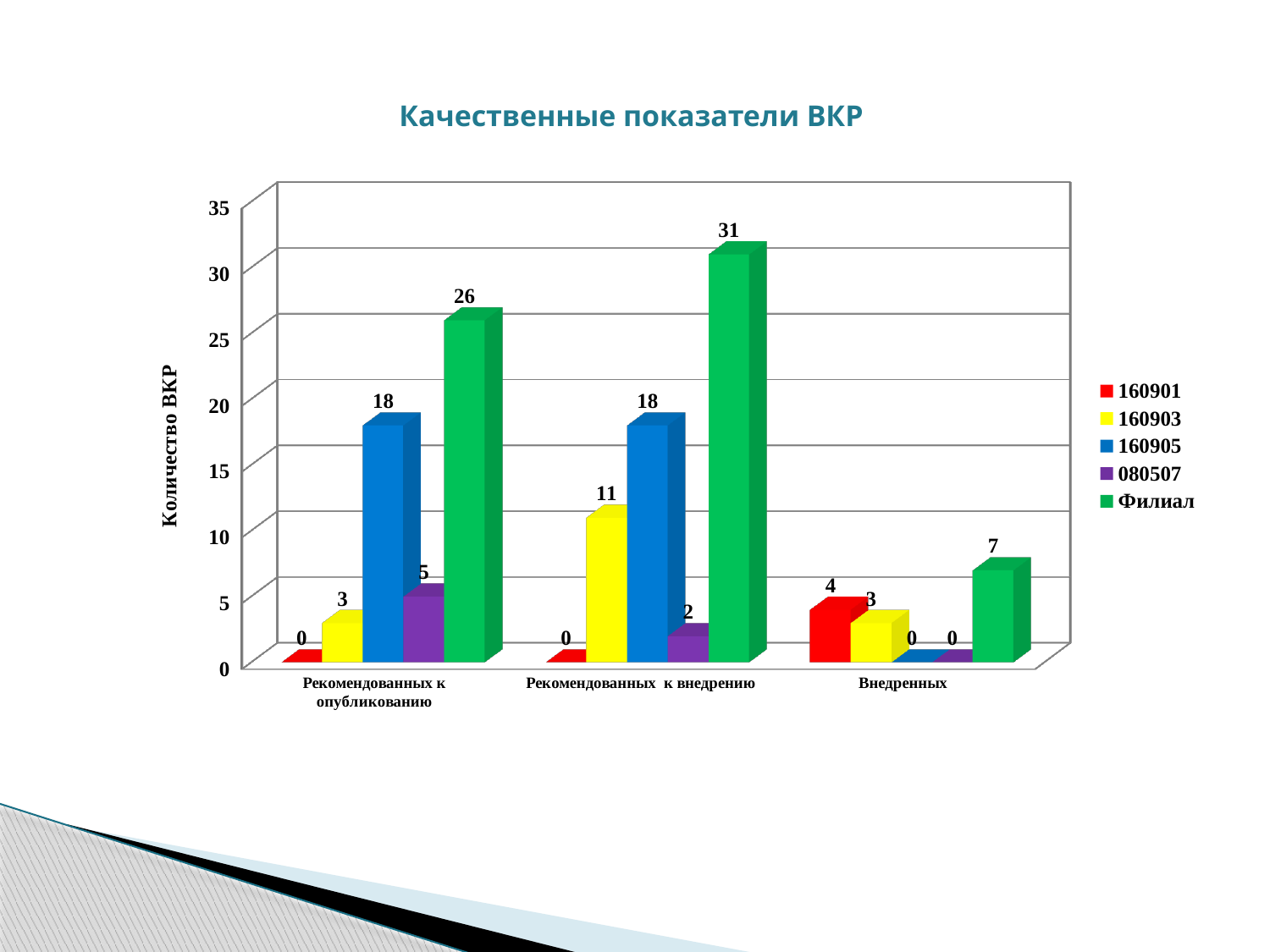
Which is larger: the 160903 value for Рекомендованных к внедрению or the 080507 value for Рекомендованных к опубликованию? 160903 value for Рекомендованных к внедрению What kind of chart is shown on the slide? Bar chart What is the value for Филиал in the Рекомендованных к внедрению category? 31 What is the value for 160901 in the Внедренных category? 4 How many series does the legend list? 5 What is the value for 080507 in the Рекомендованных к внедрению category? 2 What is the difference between the Филиал values for Рекомендованных к внедрению and Рекомендованных к опубликованию? 5 What is the value for 160903 in the Рекомендованных к опубликованию category? 3 What is the label of the vertical axis? Количество ВКР How many categories are shown on the x axis? 3 Which series has the highest value in the Рекомендованных к опубликованию category? Филиал Which series has the lowest value in the Рекомендованных к внедрению category? 160901